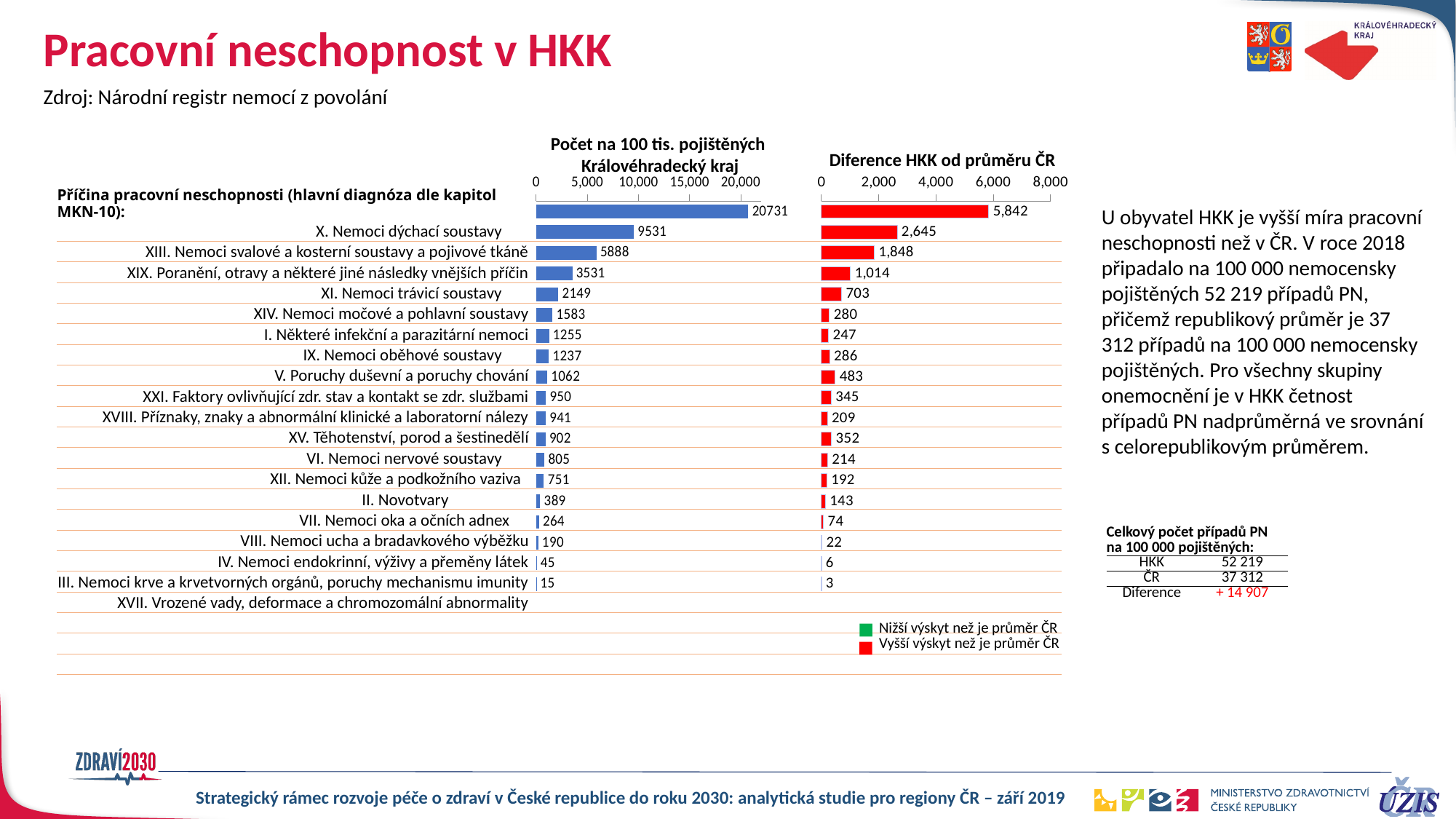
What is the title of the right chart? Diference HKK od průměru ČR In the right chart 'Diference HKK od průměru ČR', what is the difference between the two largest values (5,842 and 2,645)? 3,197 In the left chart 'Počet na 100 tis. pojištěných Královéhradecký kraj', is the largest value greater or less than 20,000? greater How many entries does the legend of the right chart list? 2 In the left chart 'Počet na 100 tis. pojištěných Královéhradecký kraj', what is the difference between the two largest values (20731 and 9531)? 11200 What kind of chart is the left chart titled 'Počet na 100 tis. pojištěných Královéhradecký kraj'? bar chart In the left chart 'Počet na 100 tis. pojištěných Královéhradecký kraj', what is the largest value shown? 20731 In the right chart 'Diference HKK od průměru ČR', what is the smallest value shown? 3 In the right chart 'Diference HKK od průměru ČR', what is the largest value shown? 5,842 In the left chart 'Počet na 100 tis. pojištěných Královéhradecký kraj', what is the smallest value shown? 15 In the right chart 'Diference HKK od průměru ČR', is the largest value greater or less than 6,000? less How many bars are plotted in the left chart 'Počet na 100 tis. pojištěných Královéhradecký kraj'? 19